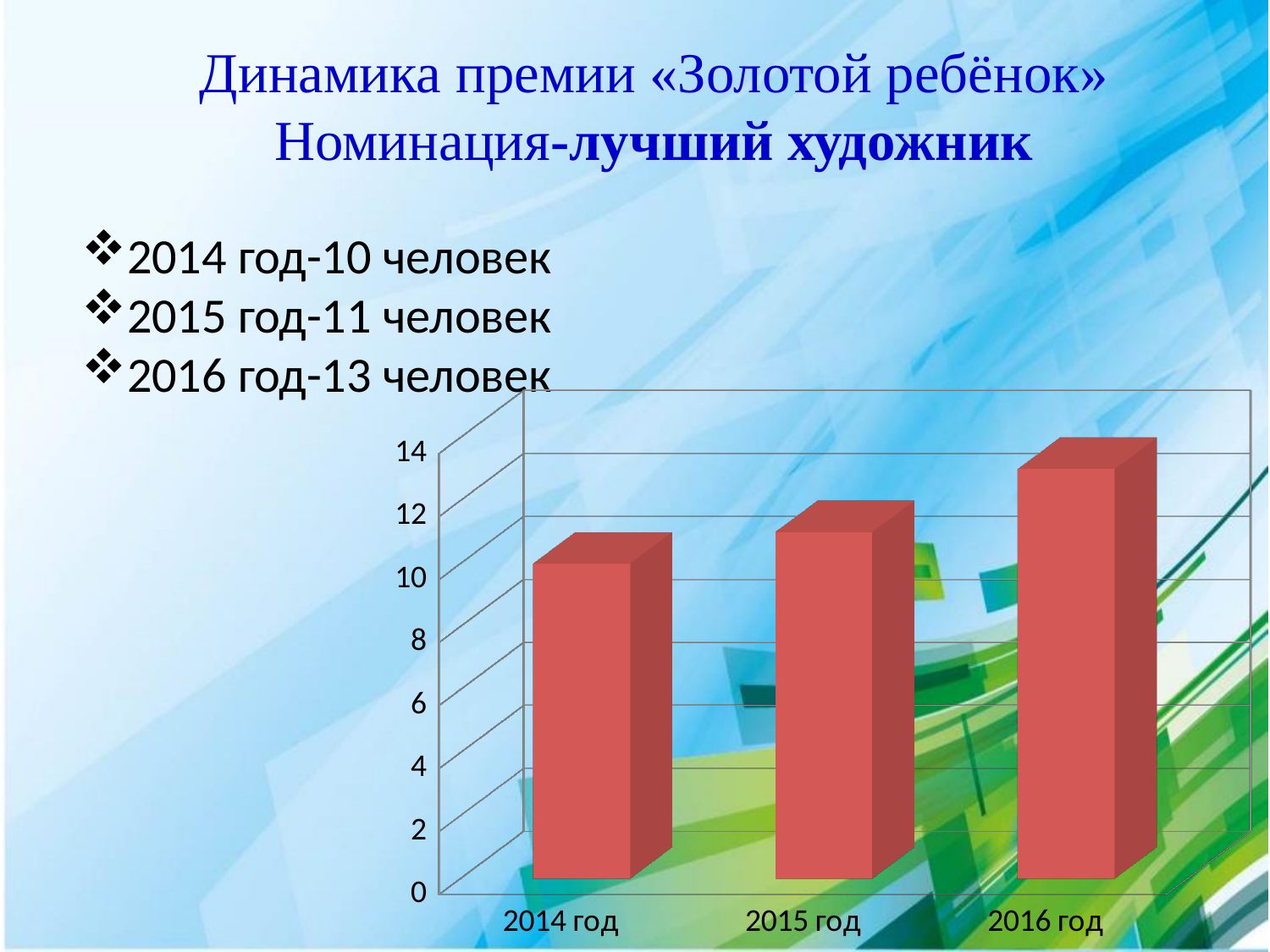
According to the slide, how many people (человек) were in the nomination in 2014 год? 10 человек Is the value for 2015 год greater or less than 12? less Which year has the lowest bar in the chart? 2014 год How many categories (years) are shown on the x axis of the chart? 3 Which year has the highest bar in the chart? 2016 год Is the value for 2016 год greater or less than 12? greater Do the values rise or fall from 2014 год to 2016 год? rise Is the bar for 2016 год taller than the bar for 2014 год? yes What kind of chart is shown on the slide? bar chart By how many people did the number grow from 2014 год to 2016 год, according to the values on the slide? 3 According to the slide, how many people (человек) were in the nomination in 2016 год? 13 человек What colour are the bars in the chart? red